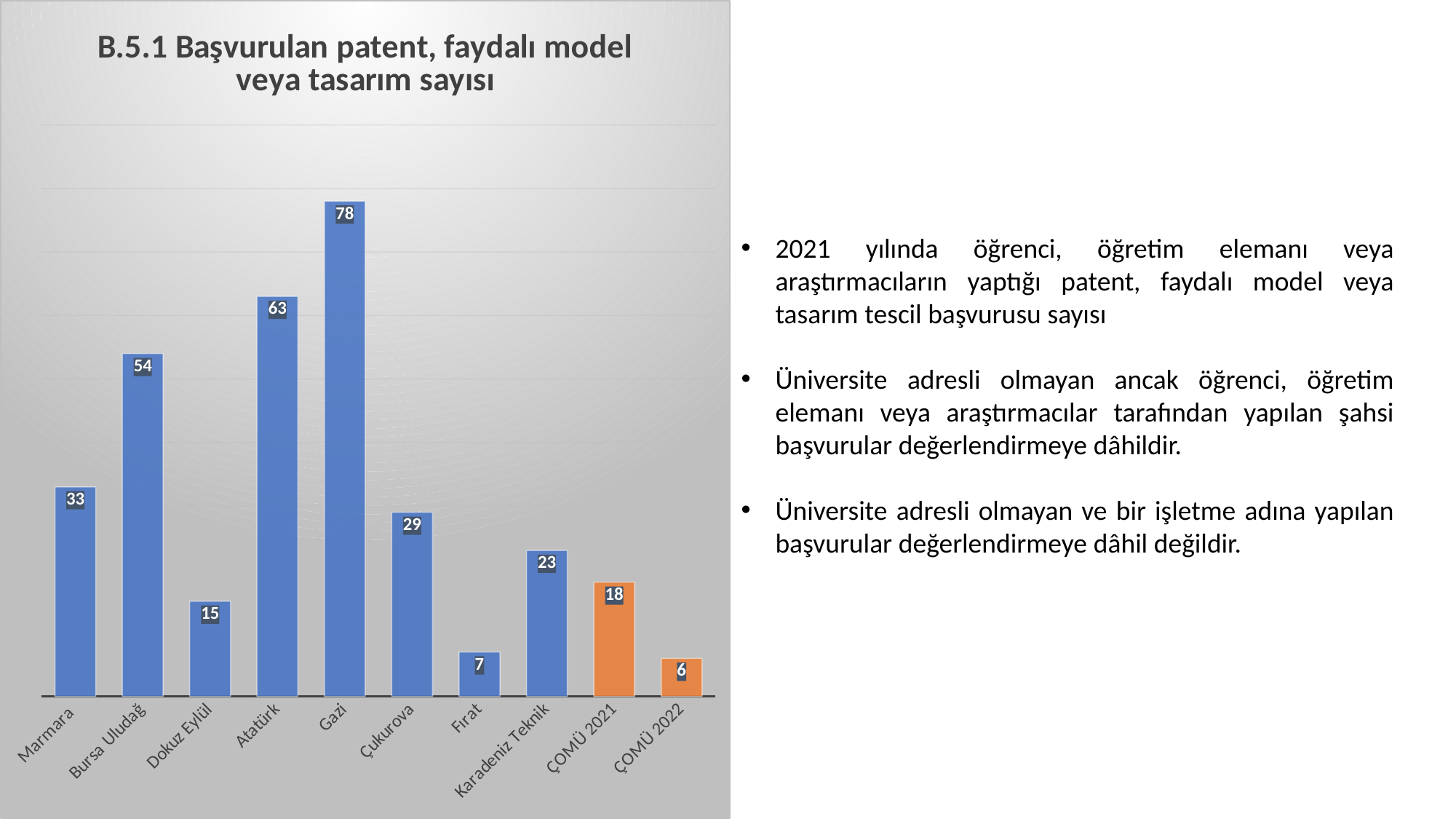
Which category has the lowest value? ÇOMÜ 2022 How many categories are shown on the x axis? 10 Which categories are shown with orange bars? ÇOMÜ 2021 and ÇOMÜ 2022 What is the difference between the values for ÇOMÜ 2021 and ÇOMÜ 2022? 12 What is the value for ÇOMÜ 2021? 18 What is the value for Gazi? 78 Which category has the highest value? Gazi What kind of chart is shown on the slide? Bar chart Which is larger, the value for Çukurova or the value for Karadeniz Teknik? Çukurova What is the title of the chart? B.5.1 Başvurulan patent, faydalı model veya tasarım sayısı What is the value for Dokuz Eylül? 15 What is the difference between the values for Atatürk and Bursa Uludağ? 9